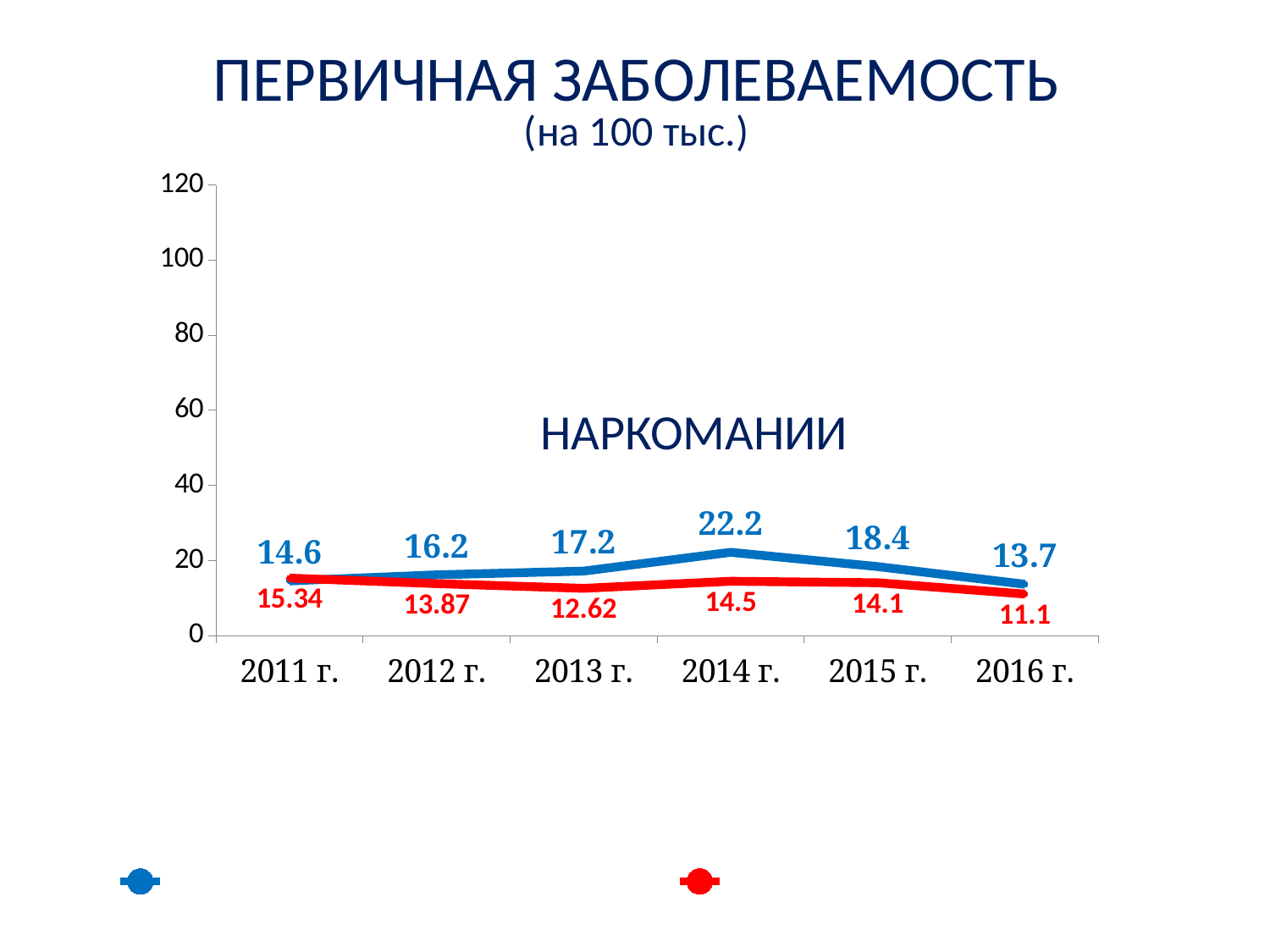
Is the blue line's value for 2014 г. greater or less than 40? less Which is larger in 2015 г., the blue line's value or the red line's value? the blue line's value (18.4) What kind of chart is shown on the slide? line chart Does the red line rise or fall from 2011 г. to 2013 г.? fall In which year does the blue line reach its highest value? 2014 г. What is the value of the red line for 2013 г.? 12.62 What is the value of the red line for 2011 г.? 15.34 What is the value of the blue line for 2014 г.? 22.2 What is the difference between the blue line's value in 2014 г. and its value in 2016 г.? 8.5 In which year does the red line have its lowest value? 2016 г. How many series does the legend list? 2 How many years are shown on the x axis? 6